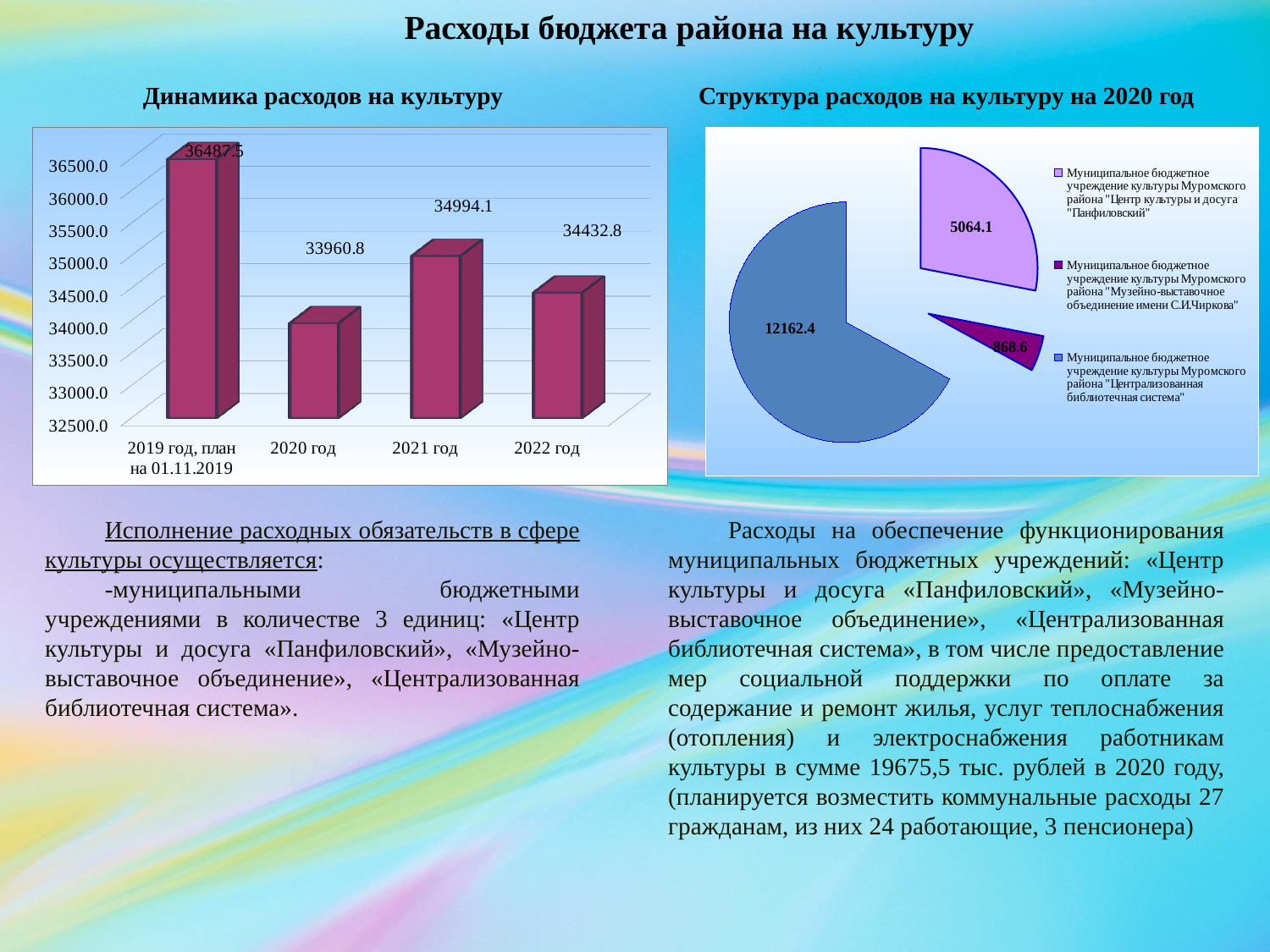
How many entries does the legend of the pie chart 'Структура расходов на культуру на 2020 год' list? 3 In the chart 'Динамика расходов на культуру', what is the difference between the values for 2019 год, план на 01.11.2019 and 2020 год? 2526.7 In the pie chart 'Структура расходов на культуру на 2020 год', what is the value for Муниципальное бюджетное учреждение культуры Муромского района "Централизованная библиотечная система"? 12162.4 In the chart 'Динамика расходов на культуру', what is the value for 2021 год? 34994.1 What type of chart is 'Динамика расходов на культуру'? bar chart In the chart 'Динамика расходов на культуру', which is larger: the value for 2021 год or 2022 год? 2021 год In the chart 'Динамика расходов на культуру', which category has the lowest value? 2020 год In the chart 'Динамика расходов на культуру', how many bars are plotted? 4 In the pie chart 'Структура расходов на культуру на 2020 год', what is the total of all slices? 18095.1 In the chart 'Динамика расходов на культуру', what is the value for 2020 год? 33960.8 In the pie chart 'Структура расходов на культуру на 2020 год', which slice is the smallest? Муниципальное бюджетное учреждение культуры Муромского района "Музейно-выставочное объединение имени С.И.Чиркова" In the chart 'Динамика расходов на культуру', which category has the highest value? 2019 год, план на 01.11.2019